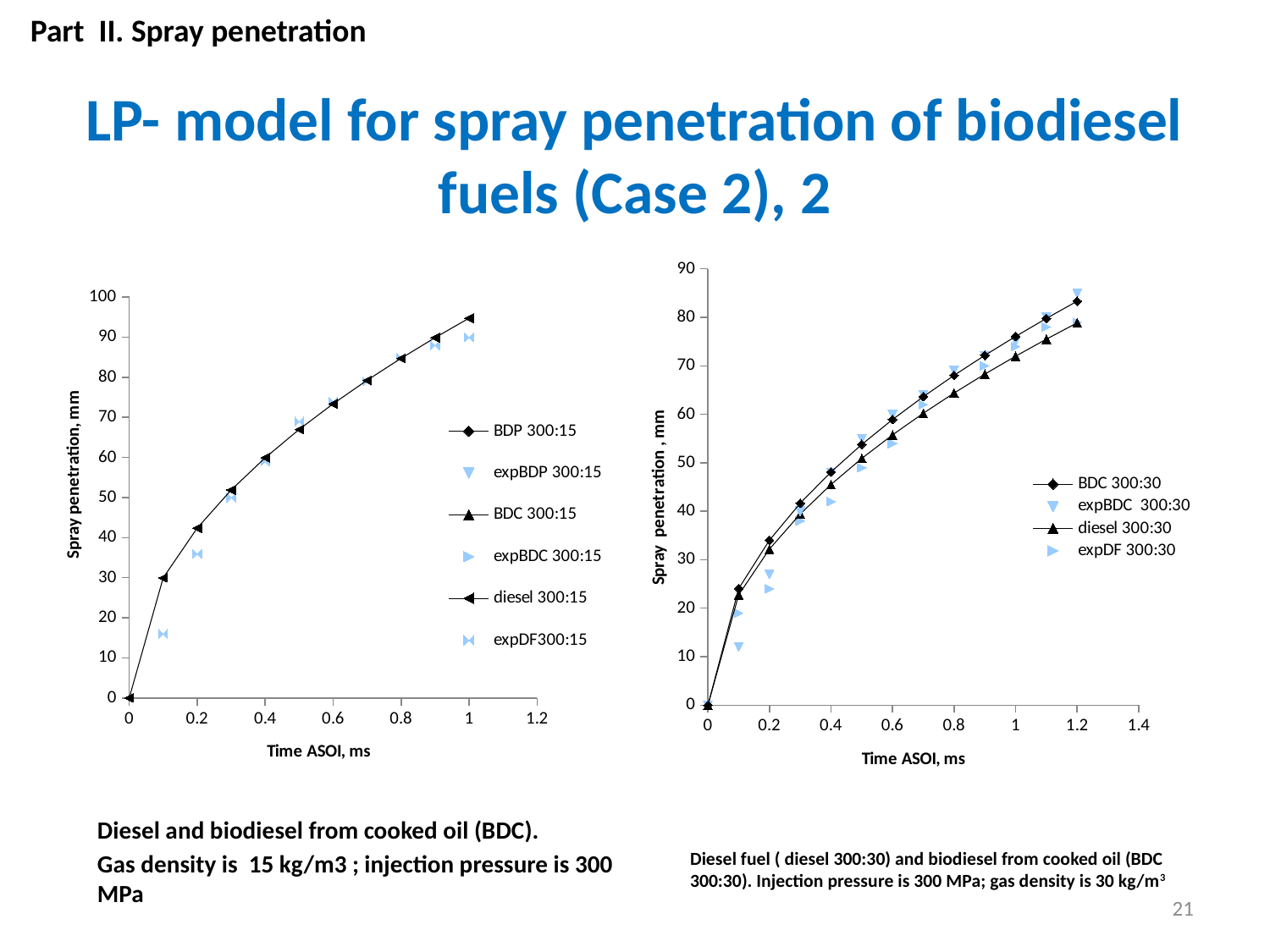
On the right chart, is the value for BDC 300:30 at 0.2 ms greater or less than 30? greater What is the y-axis title of the right chart? Spray penetration , mm What kind of chart is the left chart? Line chart On the right chart, is the value for diesel 300:30 at 0.6 ms greater or less than 50? greater What is the x-axis title of the left chart? Time ASOI, ms On the right chart, at 1.2 ms, which series has the higher value: BDC 300:30 or diesel 300:30? BDC 300:30 On the left chart, how many series does the legend list? 6 On the right chart, do the spray penetration values rise or fall as time ASOI increases? Rise On the right chart, how many series does the legend list? 4 On the right chart, is the value for BDC 300:30 at 1.2 ms greater or less than 80? greater